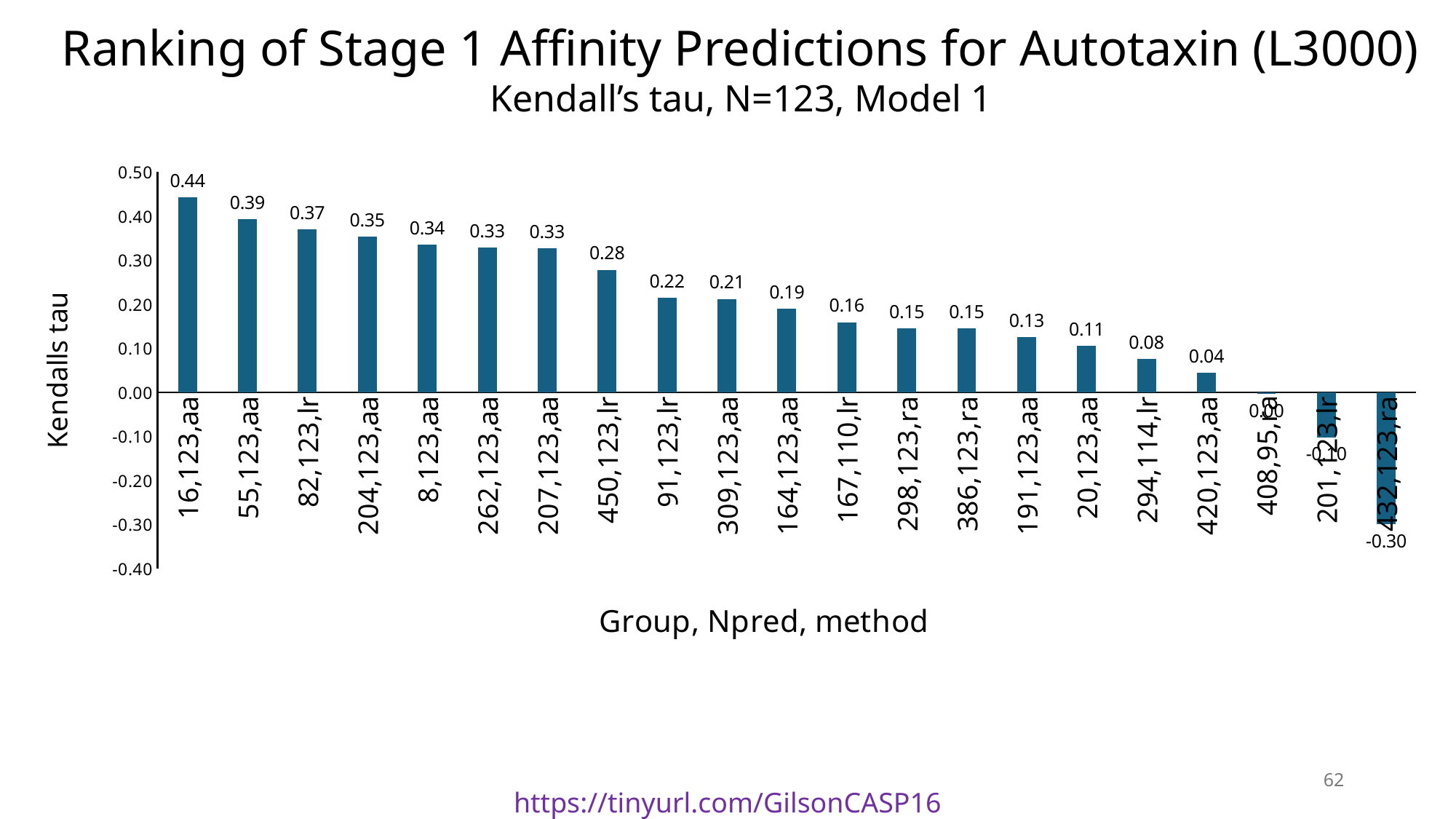
What is the label of the x axis? Group, Npred, method Which group has the lowest Kendall's tau? 432,123,ra Which group has the highest Kendall's tau? 16,123,aa What is the Kendall's tau value for 450,123,lr? 0.28 How many groups are shown on the x axis? 21 What is the Kendall's tau value for 16,123,aa? 0.44 Which has a higher Kendall's tau, 82,123,lr or 204,123,aa? 82,123,lr What kind of chart is shown on the slide? Bar chart What is the Kendall's tau value for 294,114,lr? 0.08 What is the Kendall's tau value for 432,123,ra? -0.30 What is the difference in Kendall's tau between 16,123,aa and 55,123,aa? 0.05 Do the Kendall's tau values rise or fall from left to right along the x axis? Fall